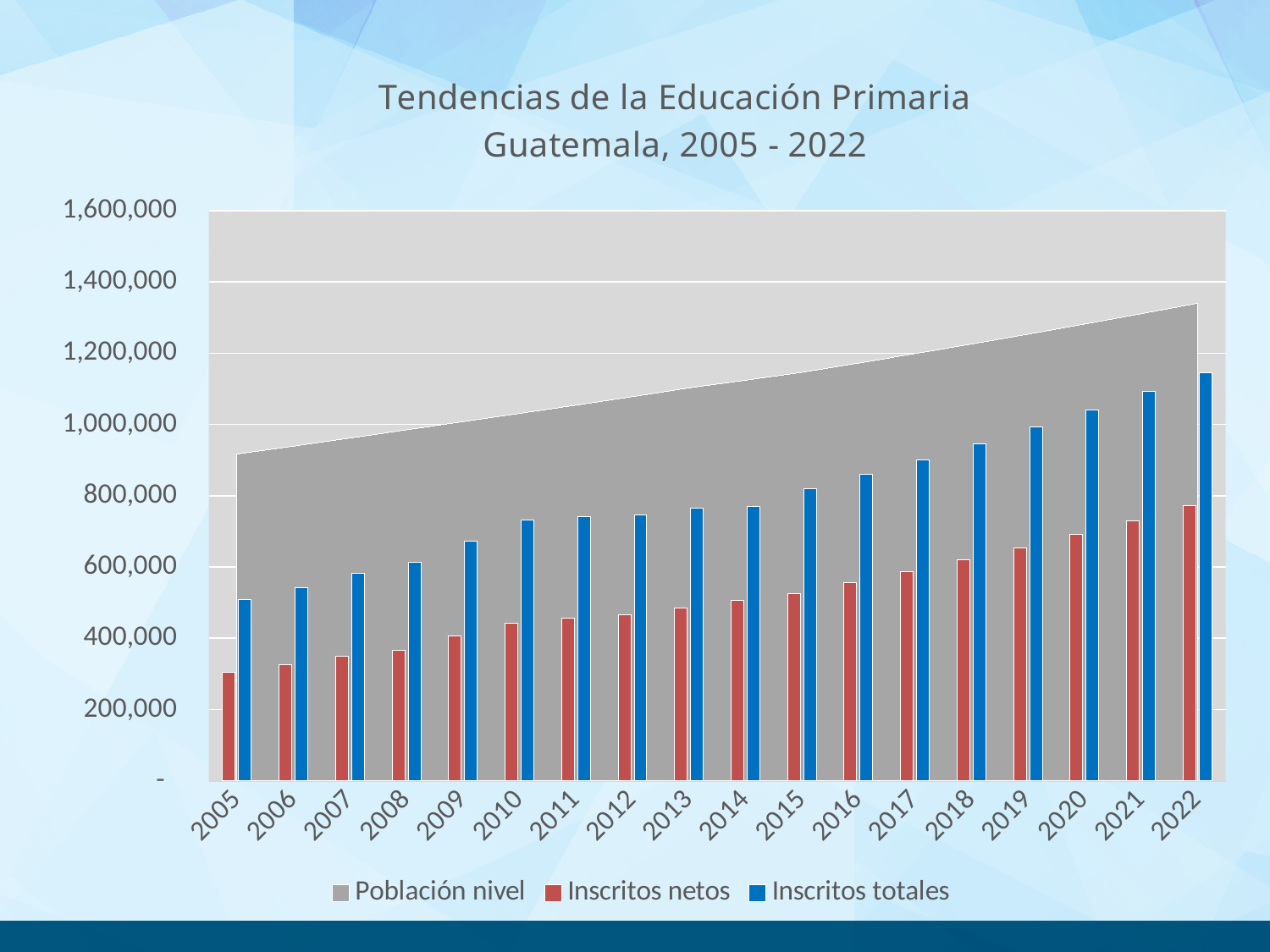
How many series does the legend list? 3 Is the value for Población nivel in 2022 greater or less than 1,400,000? less In which year is the value for Inscritos netos lowest? 2005 In 2022, which is larger: Inscritos totales or Inscritos netos? Inscritos totales Is the value for Inscritos netos in 2005 greater or less than 400,000? less How many years are shown on the x axis? 18 Do the values for Inscritos totales rise or fall from 2005 to 2022? rise Which series is drawn as a shaded area rather than bars? Población nivel In which year is the value for Inscritos totales highest? 2022 Is the value for Inscritos totales in 2022 greater or less than 1,000,000? greater What is the title of the chart? Tendencias de la Educación Primaria Guatemala, 2005 - 2022